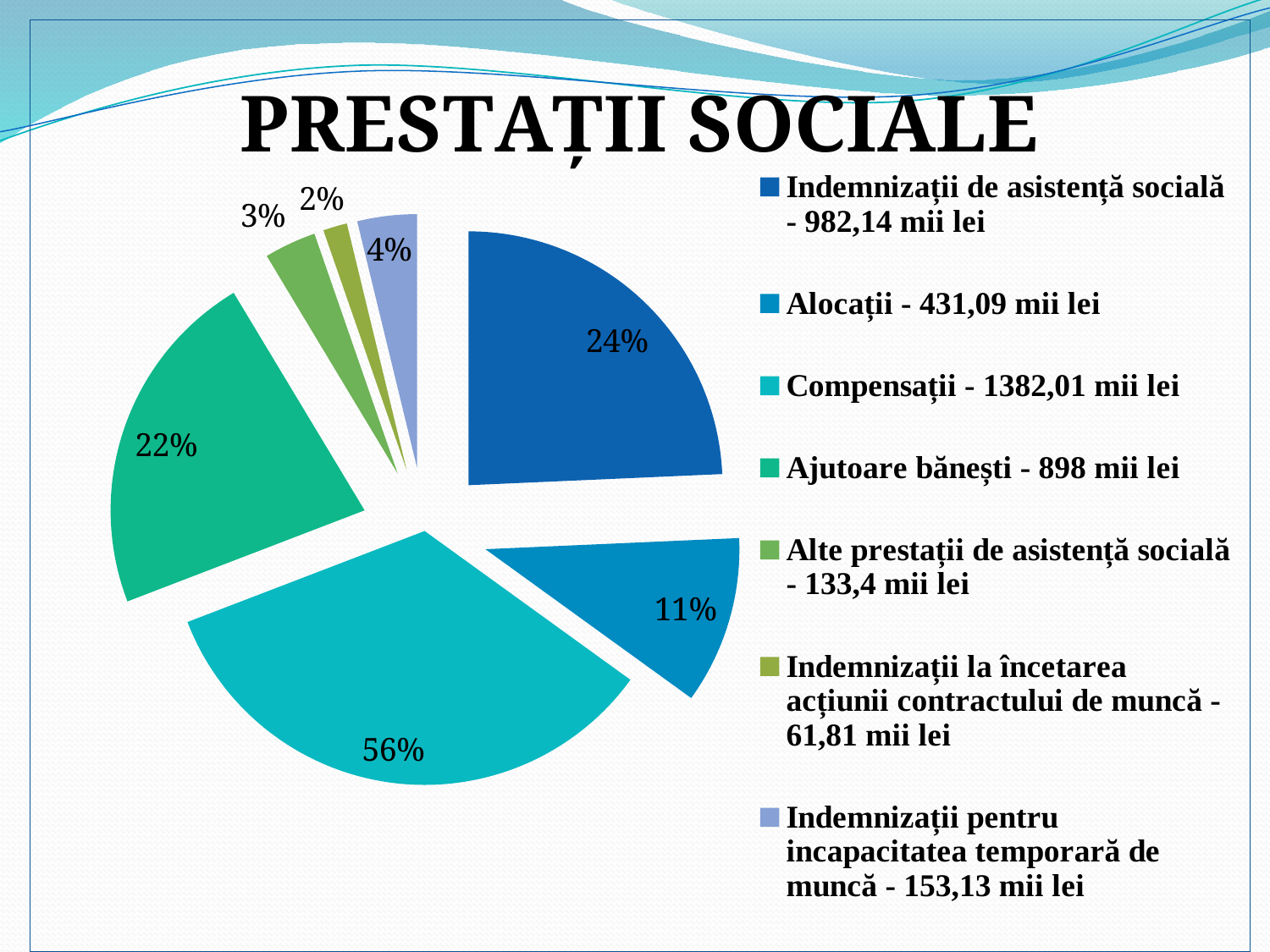
What value does the legend give for Ajutoare bănești? 898 mii lei What percentage share is labelled on the Compensații slice? 56% What value does the legend give for Compensații? 1382,01 mii lei Which category has the largest slice of the pie? Compensații What is the difference between the legend values for Compensații and Indemnizații de asistență socială? 399,87 mii lei What kind of chart is shown on the slide? pie chart What is the title of the chart? PRESTAȚII SOCIALE Which is larger, Indemnizații de asistență socială or Alocații? Indemnizații de asistență socială How many slices does the pie chart have? 7 Which category has the smallest slice of the pie? Indemnizații la încetarea acțiunii contractului de muncă What value does the legend give for Indemnizații la încetarea acțiunii contractului de muncă? 61,81 mii lei What percentage share is labelled on the Alocații slice? 11%